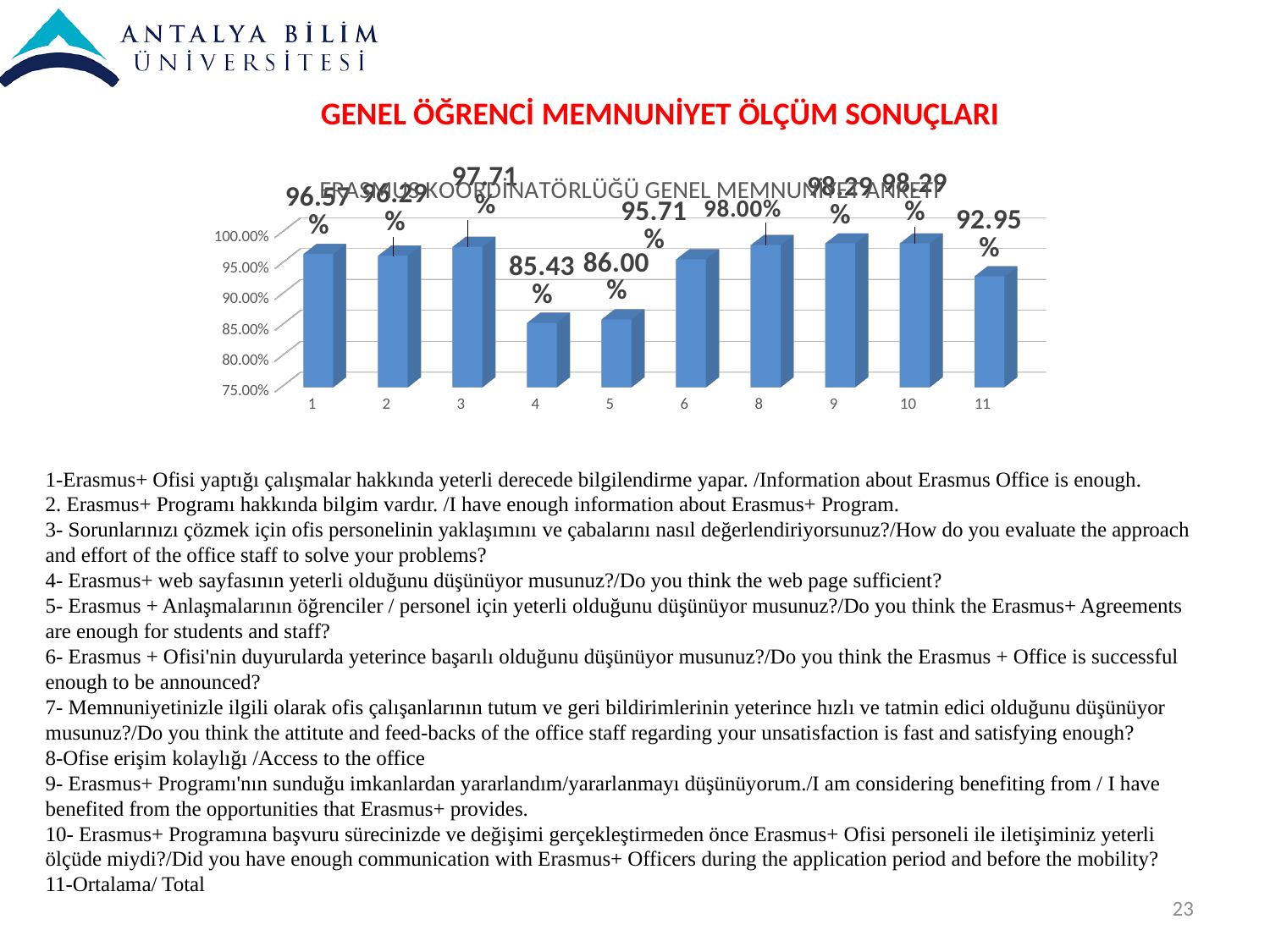
How many bars are plotted in the chart? 10 What is the lowest value shown on the vertical axis of the chart? 75.00% Which category has the lowest value in the chart? 4 What is the value for category 4 in the chart? 85.43% What kind of chart is shown on the slide? Bar chart What is the value for category 8 in the chart? 98.00% What is the difference between the values for category 8 and category 6? 2.29% What is the difference between the values for category 3 and category 1? 1.14% Which has the larger value, category 1 or category 2? Category 1 What is the value for category 11 in the chart? 92.95% What is the value for category 3 in the chart? 97.71% Is the value for category 4 greater or less than 90.00%? less